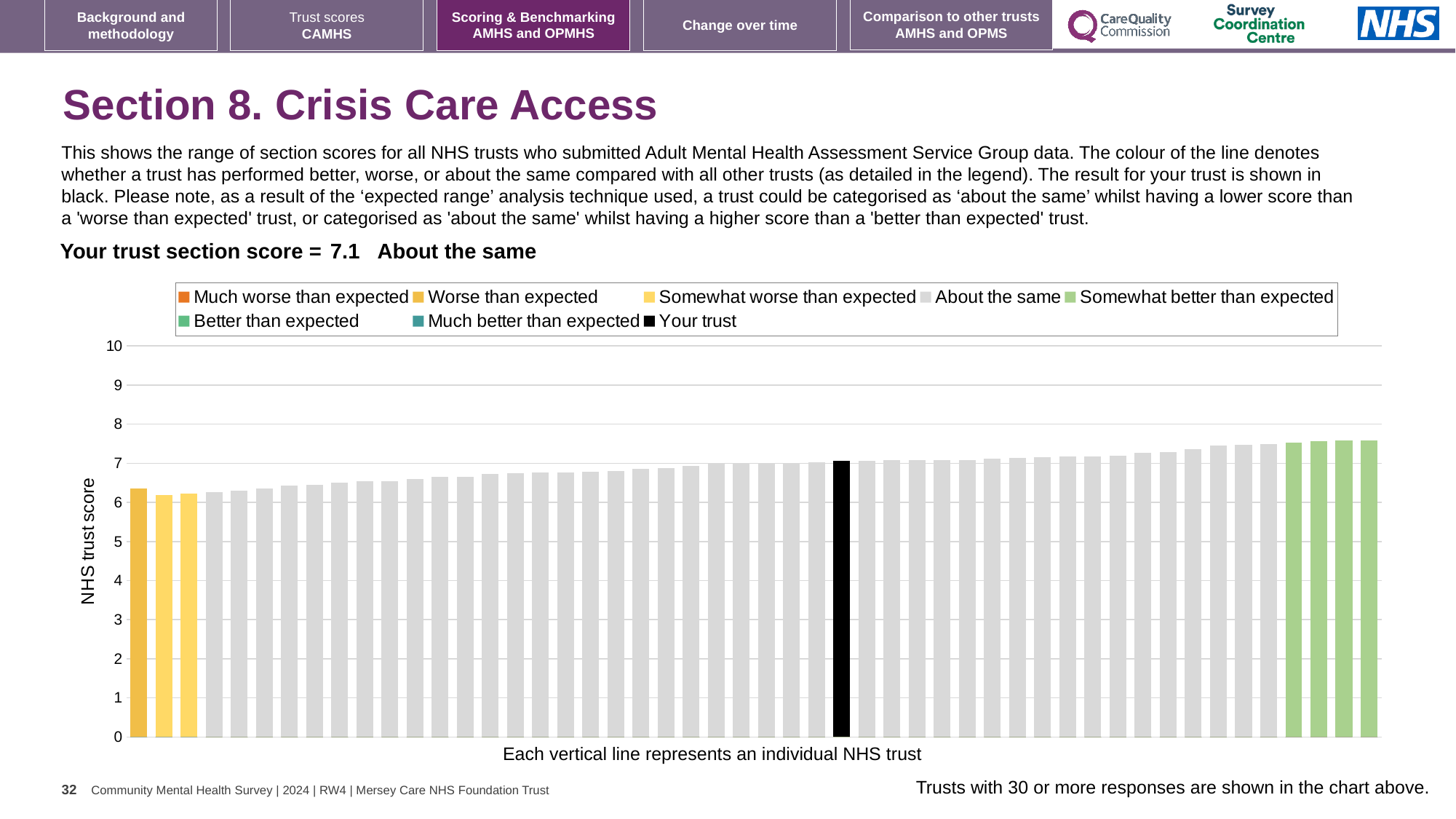
What kind of chart is shown on the slide? bar chart Is your trust's bar taller or shorter than the leftmost bar? taller Is the value for your trust's bar greater or less than 5? greater How many entries does the chart legend list? 8 Is the value of the tallest bar in the chart greater or less than 8? less Which performance category is your trust placed in for this section? About the same What colour is used for the bar representing your trust? black How many bars are coloured as 'Somewhat better than expected' (green)? 4 What is the section score for your trust shown on the slide? 7.1 Do the bar values rise or fall moving from left to right along the x axis? rise Is the value of the leftmost bar in the chart greater or less than 6? greater What is the label on the y axis of the chart? NHS trust score